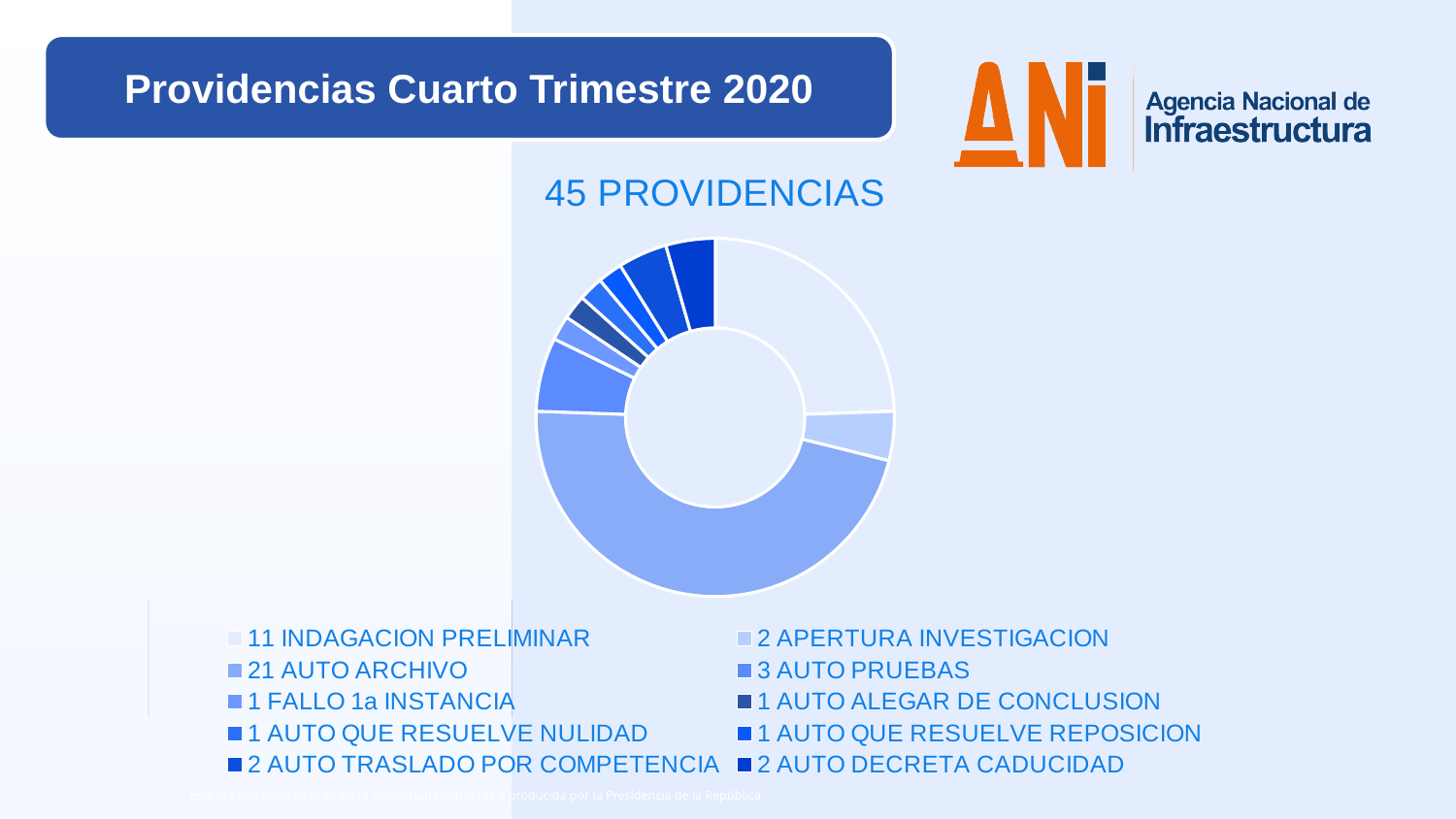
How many providencias are AUTO ARCHIVO? 21 What is the chart's title? 45 PROVIDENCIAS How many providencias are AUTO PRUEBAS? 3 How many providencias are INDAGACION PRELIMINAR? 11 How many providencias are FALLO 1a INSTANCIA? 1 How many providencias are AUTO DECRETA CADUCIDAD? 2 What type of chart is shown on the slide? Doughnut (pie) chart What is the total number of providencias shown in the chart? 45 How many categories does the chart's legend list? 10 Which category has the largest number of providencias? AUTO ARCHIVO What is the difference between the number of AUTO ARCHIVO and INDAGACION PRELIMINAR providencias? 10 Which has more providencias, AUTO PRUEBAS or APERTURA INVESTIGACION? AUTO PRUEBAS